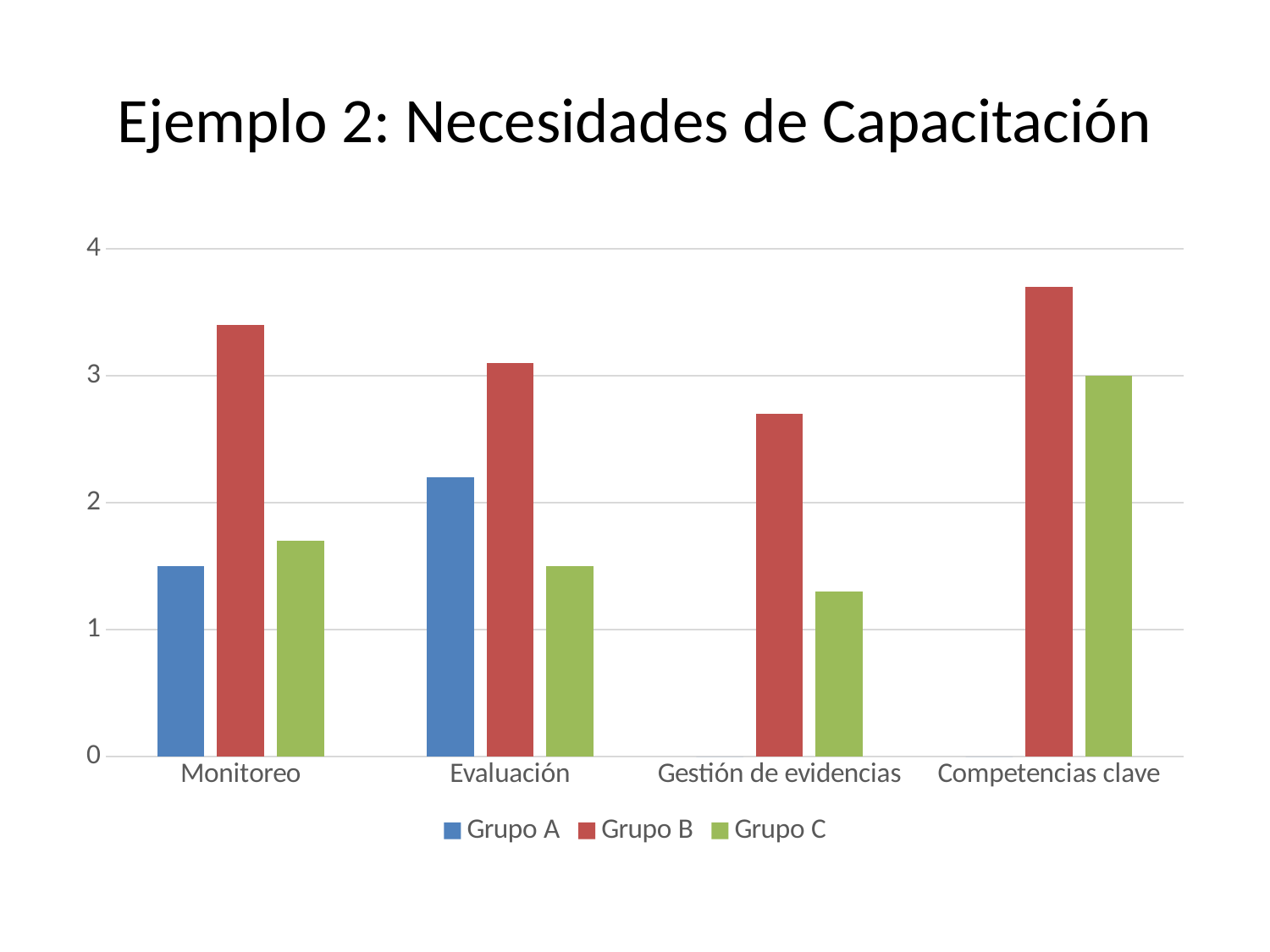
What is the title of the slide? Ejemplo 2: Necesidades de Capacitación Which is larger in Evaluación, the value for Grupo A or the value for Grupo B? Grupo B How many categories are shown on the x axis? 4 How many series does the legend list? 3 Is the value for Grupo A in Evaluación greater or less than 2? greater Is the value for Grupo B in Monitoreo greater or less than 3? greater Which category has the lowest value for Grupo B? Gestión de evidencias What kind of chart is shown on the slide? bar chart Is the value for Grupo C in Gestión de evidencias greater or less than 2? less Which category has the highest value for Grupo C? Competencias clave Which series is shown in red in the legend? Grupo B Which category has the highest value for Grupo B? Competencias clave